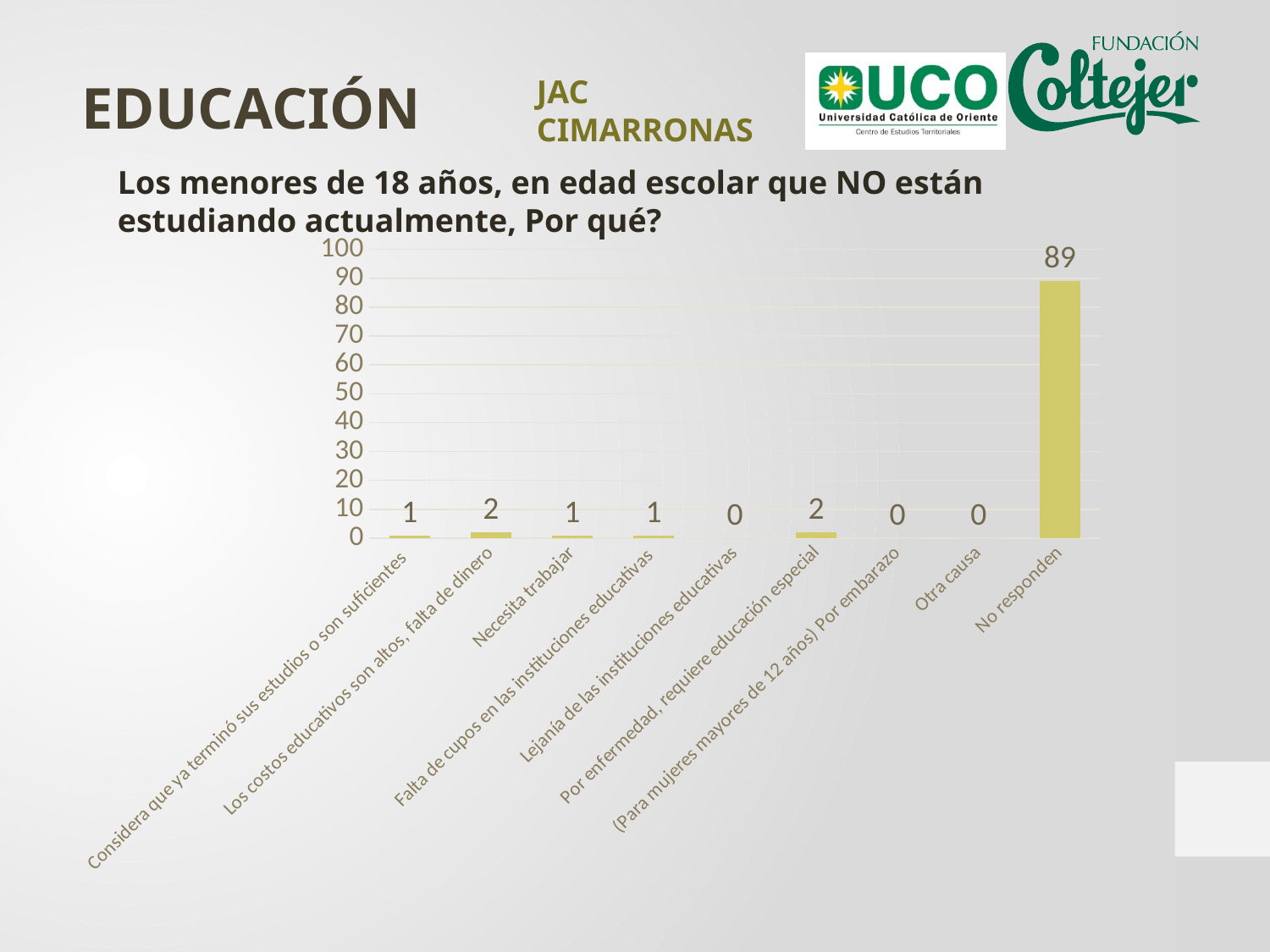
What value is shown for "No responden"? 89 What value is shown for "Por enfermedad, requiere educación especial"? 2 What value is shown for "Necesita trabajar"? 1 Is the value for "No responden" greater or less than 80? greater Which is larger, the value for "Necesita trabajar" or the value for "Por enfermedad, requiere educación especial"? Por enfermedad, requiere educación especial How many categories have a value of 0? 3 Which category has the highest value? No responden What is the difference between the values for "No responden" and "Los costos educativos son altos, falta de dinero"? 87 What value is shown for "Los costos educativos son altos, falta de dinero"? 2 What value is shown for "Otra causa"? 0 How many categories are shown on the x axis? 9 What kind of chart is shown on the slide? bar chart